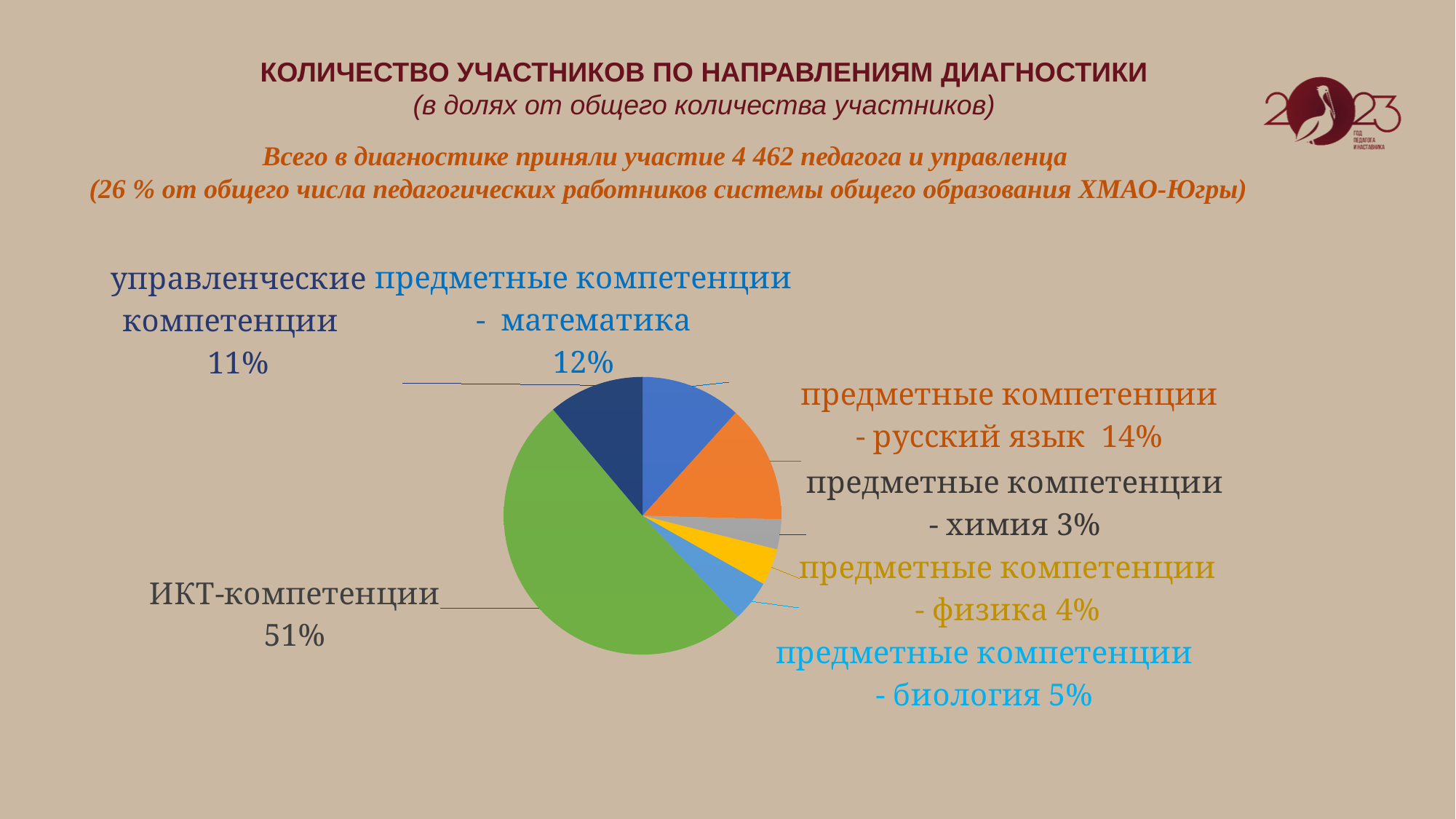
What is the difference in percentage points between предметные компетенции - русский язык and предметные компетенции - математика? 2 What share of participants is shown for ИКТ-компетенции? 51% Which has a larger share: предметные компетенции - биология or предметные компетенции - физика? предметные компетенции - биология What share is shown for предметные компетенции - химия? 3% Which category has the smallest share of the pie? предметные компетенции - химия How many slices does the pie chart have? 7 What kind of chart is shown on the slide? pie chart What colour is the slice for ИКТ-компетенции? green What share is shown for предметные компетенции - математика? 12% Which category has the largest share of the pie? ИКТ-компетенции What share is shown for управленческие компетенции? 11% What share is shown for предметные компетенции - русский язык? 14%